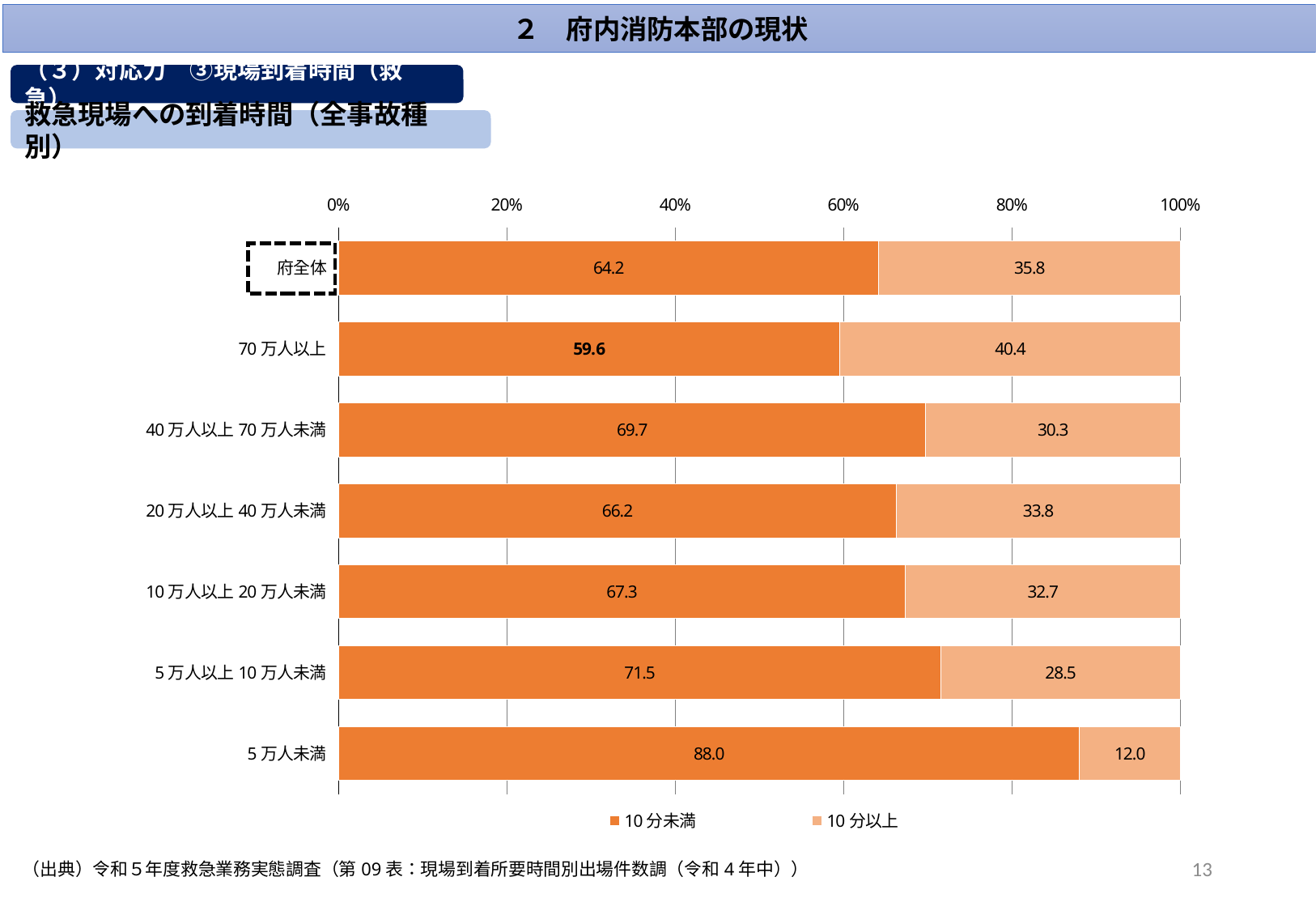
What is the value of 10分以上 for 70万人以上? 40.4 What is the difference between the 10分未満 values for 5万人未満 and 70万人以上? 28.4 What are the two series listed in the legend? 10分未満 and 10分以上 Which is larger, the 10分未満 value for 40万人以上70万人未満 or for 20万人以上40万人未満? 40万人以上70万人未満 What is the total of the stacked bar for 5万人以上10万人未満? 100.0 What is the value of 10分未満 for 5万人未満? 88.0 Which category has the lowest value for 10分未満? 70万人以上 What kind of chart is shown on the slide? Stacked bar chart How many series does the legend list? 2 Which category has the highest value for 10分未満? 5万人未満 What is the value of 10分未満 for 府全体? 64.2 How many categories are shown on the chart? 7